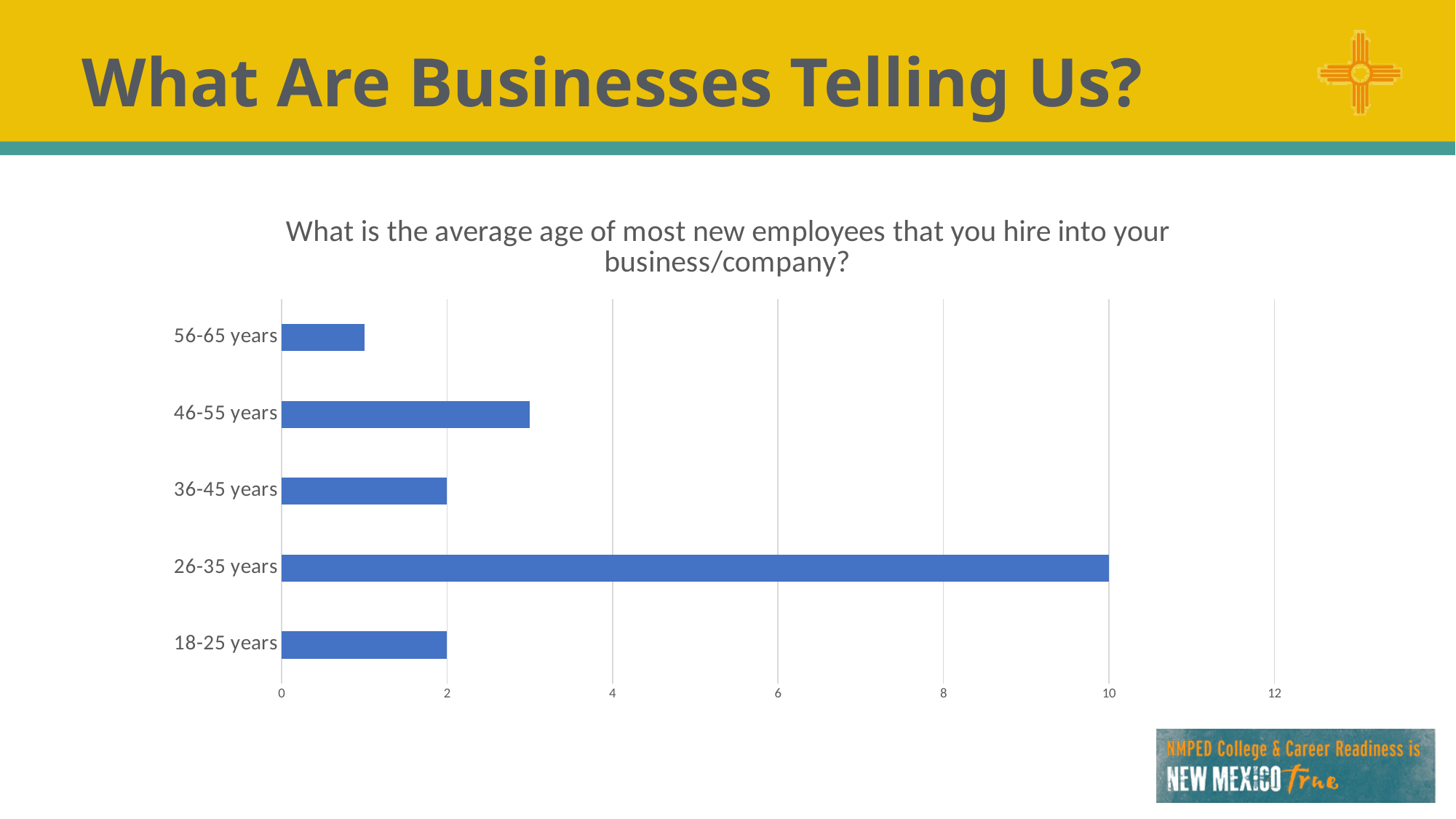
How many age categories are shown in the chart? 5 What is the difference between the values for 26-35 years and 18-25 years? 8 Which age category has the lowest value? 56-65 years Is the value for 56-65 years greater or less than 2? less What is the title of the chart? What is the average age of most new employees that you hire into your business/company? What kind of chart is shown on the slide? Bar chart Which is larger, the value for 46-55 years or the value for 36-45 years? 46-55 years Which age category has the highest value? 26-35 years What is the value for 36-45 years? 2 What is the value for 18-25 years? 2 What is the value for 26-35 years? 10 Is the value for 46-55 years greater or less than 4? less